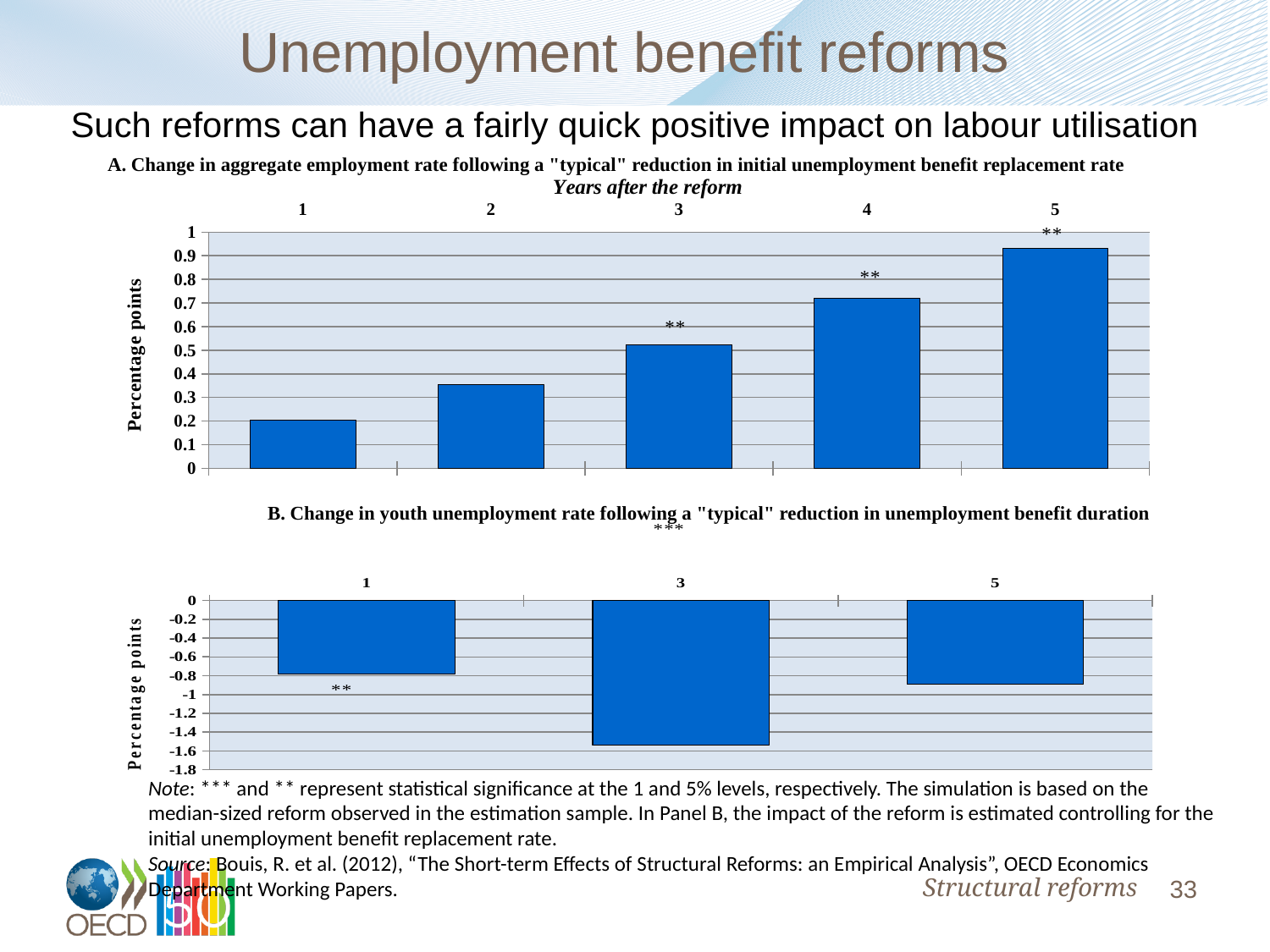
In Panel A, do the values rise or fall as the years after the reform increase? rise In Panel A, is the value for year 2 greater or less than 0.4? less In Panel B (change in youth unemployment rate), which year has the most negative value? 3 How many bars are plotted in Panel A? 5 In Panel B, is the value for year 3 greater or less than -1.4? less How many bars are plotted in Panel B? 3 In Panel A, is the value for year 3 larger than the value for year 2? Yes, year 3 In Panel A, is the value for year 4 greater or less than 0.6? greater In Panel A (change in aggregate employment rate), which year after the reform has the highest value? 5 What kind of chart is Panel B? bar chart In Panel A (change in aggregate employment rate), which year after the reform has the lowest value? 1